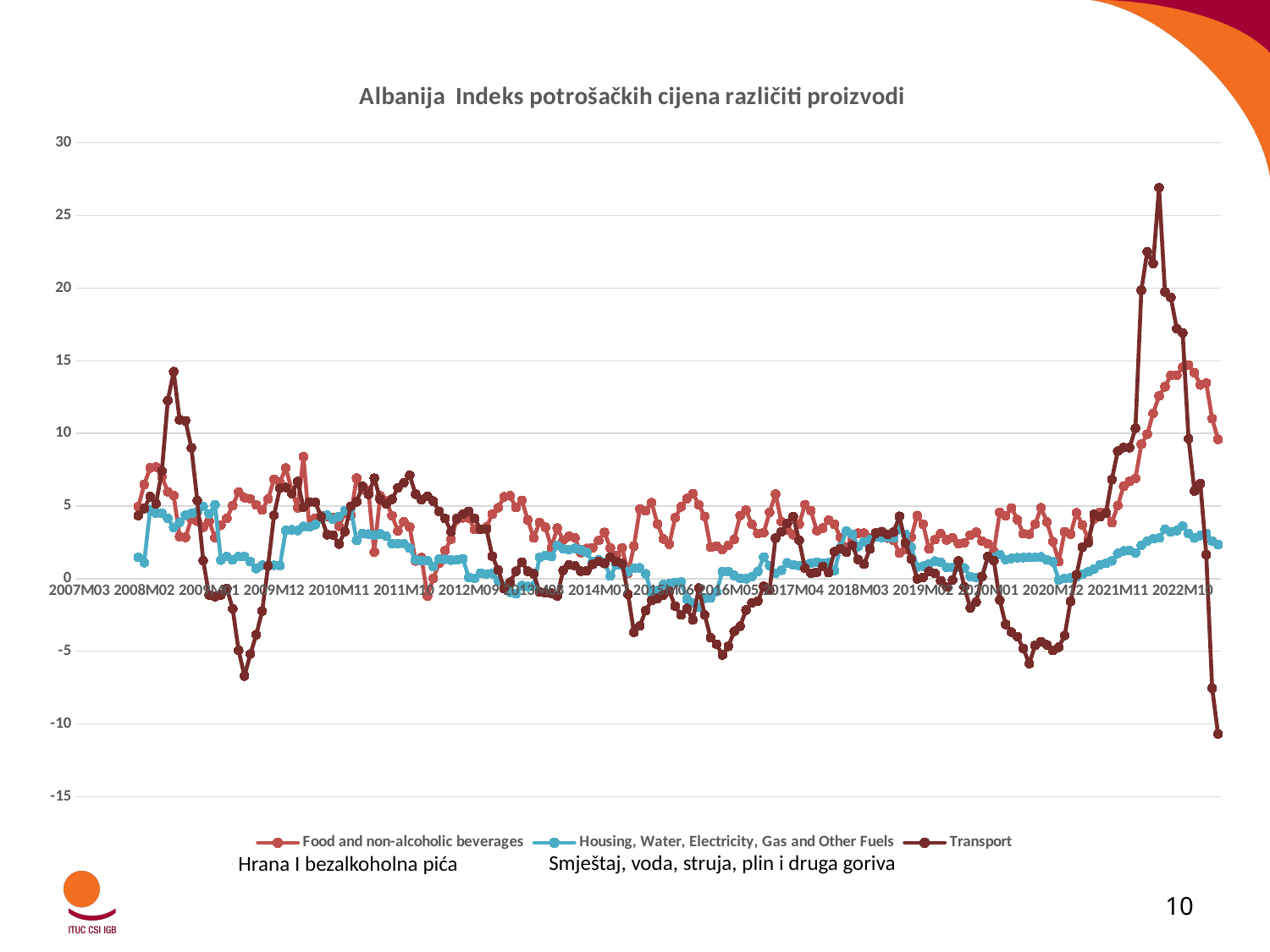
How many series does the legend list? 3 Which series reaches the lowest value on the chart? Transport What is the title of the chart? Albanija Indeks potrošačkih cijena različiti proizvodi Around 2008, is the peak of the Transport series greater or less than 10? greater What kind of chart is shown on the slide? line chart Which series is drawn in blue? Housing, Water, Electricity, Gas and Other Fuels Is the peak value of the Food and non-alcoholic beverages series greater or less than 10? greater Is the highest value of the Housing, Water, Electricity, Gas and Other Fuels series greater or less than 10? less How many date labels are shown along the x axis? 18 Which series reaches the highest value on the chart? Transport